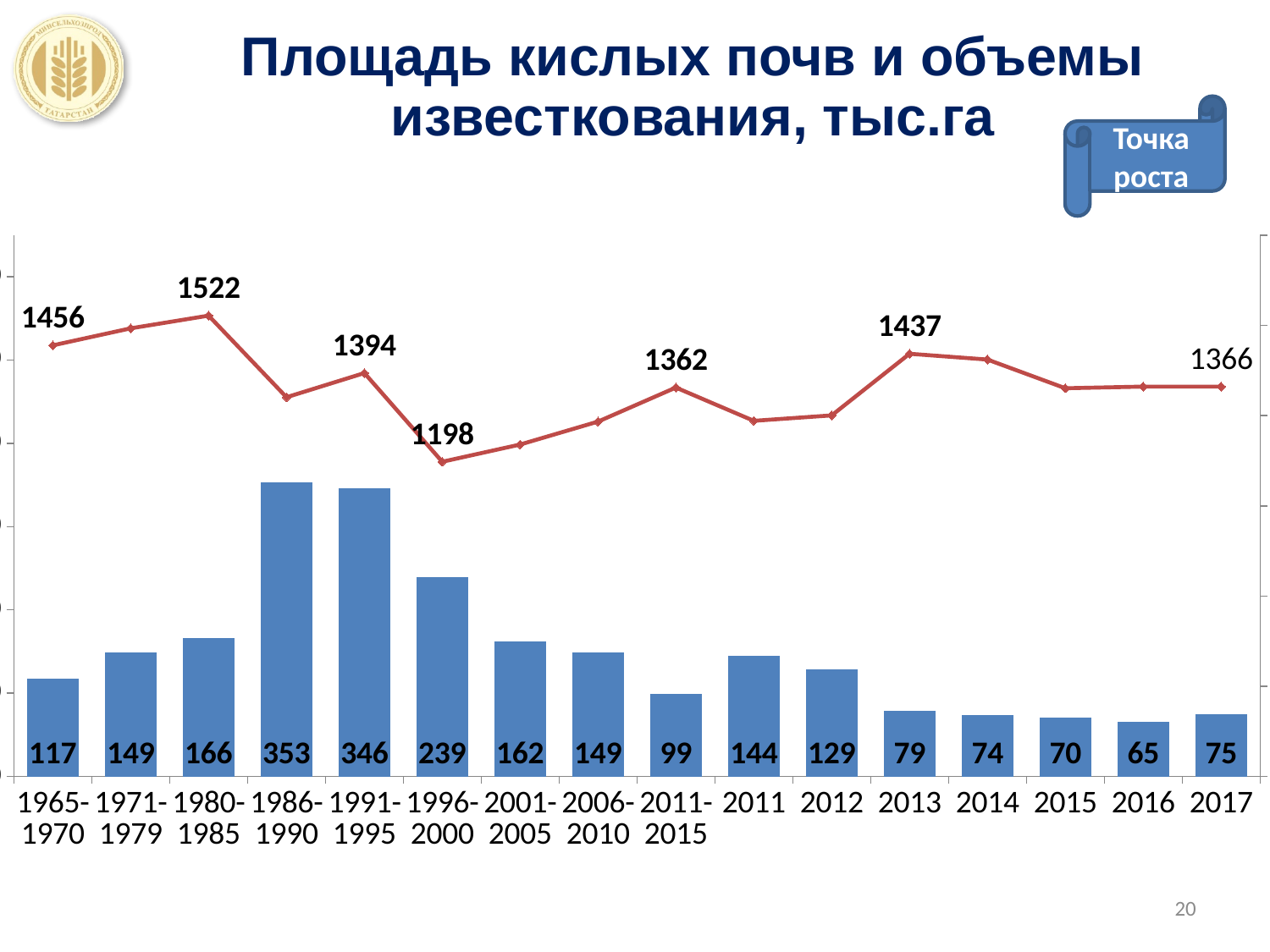
Which period has the highest bar? 1986-1990 What is the difference between the line values for 1980-1985 and 1996-2000? 324 What is the bar value for 2016? 65 Do the bar values rise or fall from 2013 to 2016? fall What value does the line show for 1980-1985? 1522 What is the bar value for 1986-1990? 353 Which has a larger bar value, 2011 or 2012? 2011 What is the difference between the bar values for 1986-1990 and 1991-1995? 7 How many categories are shown on the x axis? 16 Which year has the lowest bar? 2016 What value does the line show for 2017? 1366 Which period has the lowest point on the line? 1996-2000